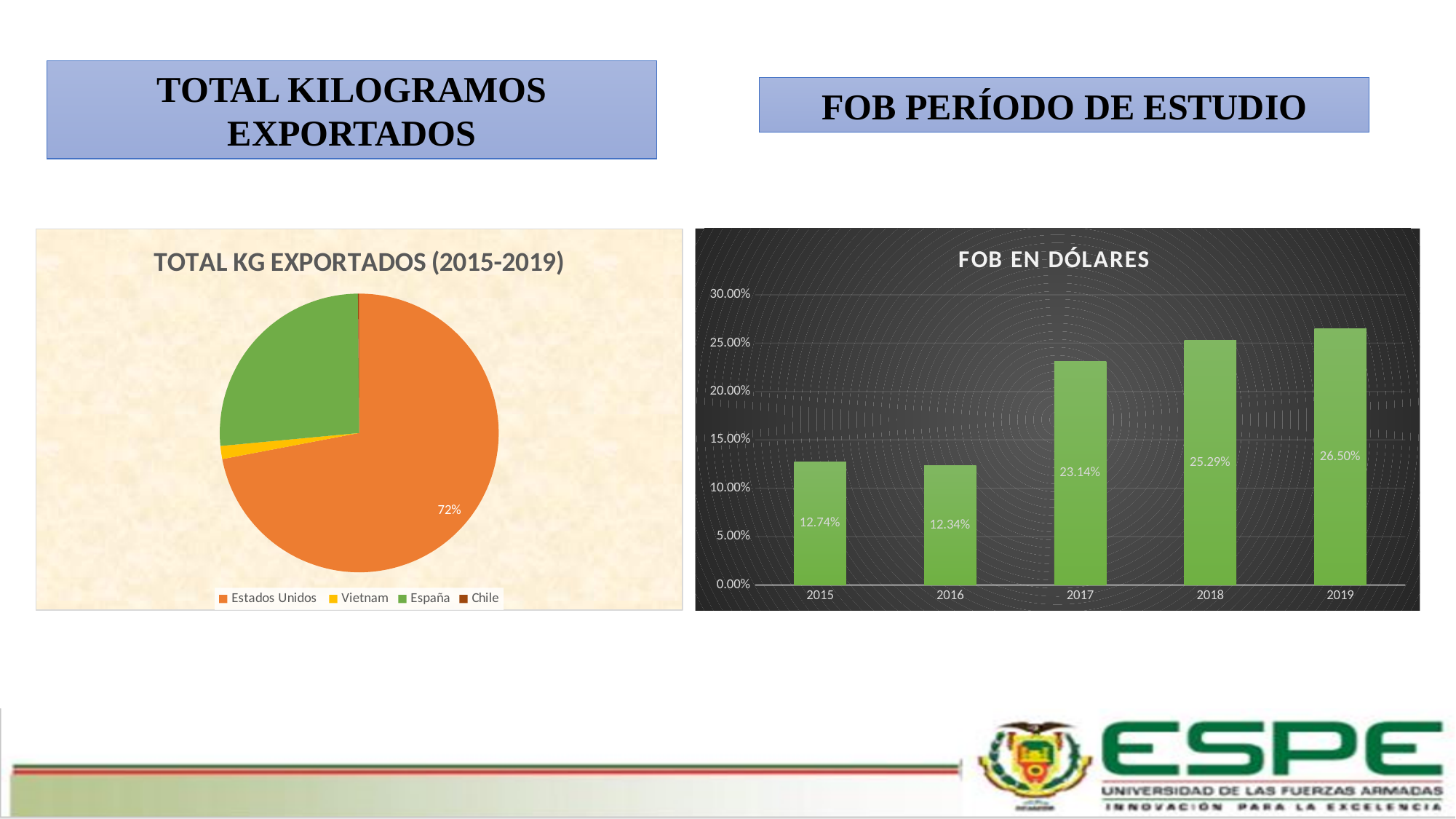
In the FOB EN DÓLARES chart, which is larger, the value for 2017 or the value for 2018? 2018 In the FOB EN DÓLARES chart, what is the value for 2017? 23.14% In the FOB EN DÓLARES chart, what is the difference between the values for 2018 and 2017? 2.15% In the FOB EN DÓLARES chart, which year has the lowest value? 2016 How many years are shown on the x axis of the FOB EN DÓLARES chart? 5 What kind of chart is the FOB EN DÓLARES chart? bar chart In the FOB EN DÓLARES chart, what is the difference between the values for 2019 and 2015? 13.76% In the FOB EN DÓLARES chart, which year has the highest value? 2019 How many entries does the legend of the TOTAL KG EXPORTADOS (2015-2019) pie chart list? 4 In the FOB EN DÓLARES chart, is the value for 2019 greater or less than 25.00%? greater In the TOTAL KG EXPORTADOS (2015-2019) pie chart, what share does Estados Unidos have? 72% In the FOB EN DÓLARES chart, what is the value for 2015? 12.74%